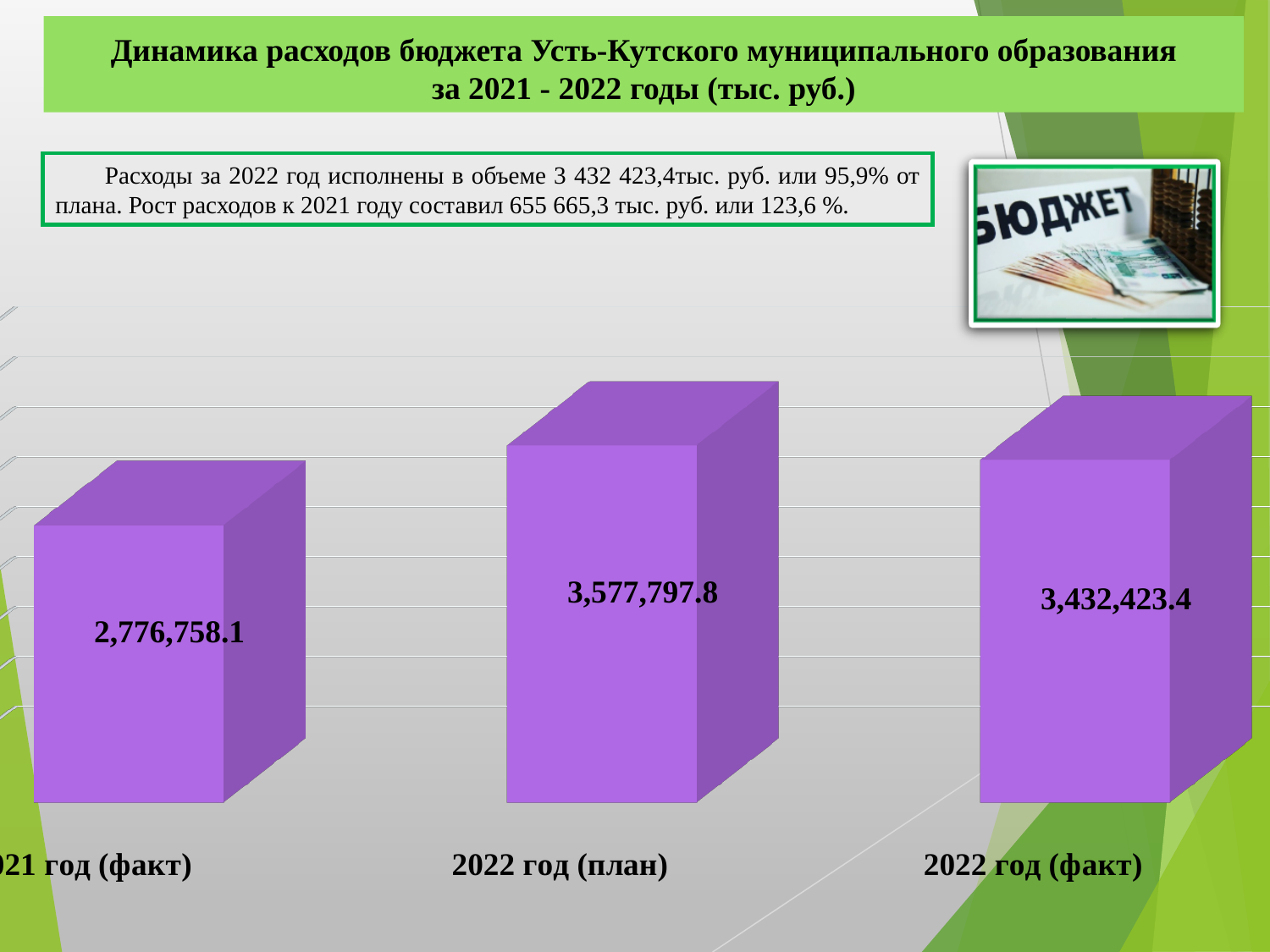
Which category has the highest value? 2022 год (план) Which is larger, the value for 2021 год (факт) or the value for 2022 год (факт)? 2022 год (факт) What is the difference between the values for 2022 год (план) and 2022 год (факт)? 145,374.4 What is the value for 2021 год (факт)? 2,776,758.1 What is the difference between the values for 2022 год (факт) and 2021 год (факт)? 655,665.3 How many bars are shown in the chart? 3 What kind of chart is shown on the slide? bar chart What is the value for 2022 год (план)? 3,577,797.8 Which is larger, the value for 2022 год (план) or the value for 2022 год (факт)? 2022 год (план) Which category has the lowest value? 2021 год (факт) What colour are the bars in the chart? purple What is the value for 2022 год (факт)? 3,432,423.4